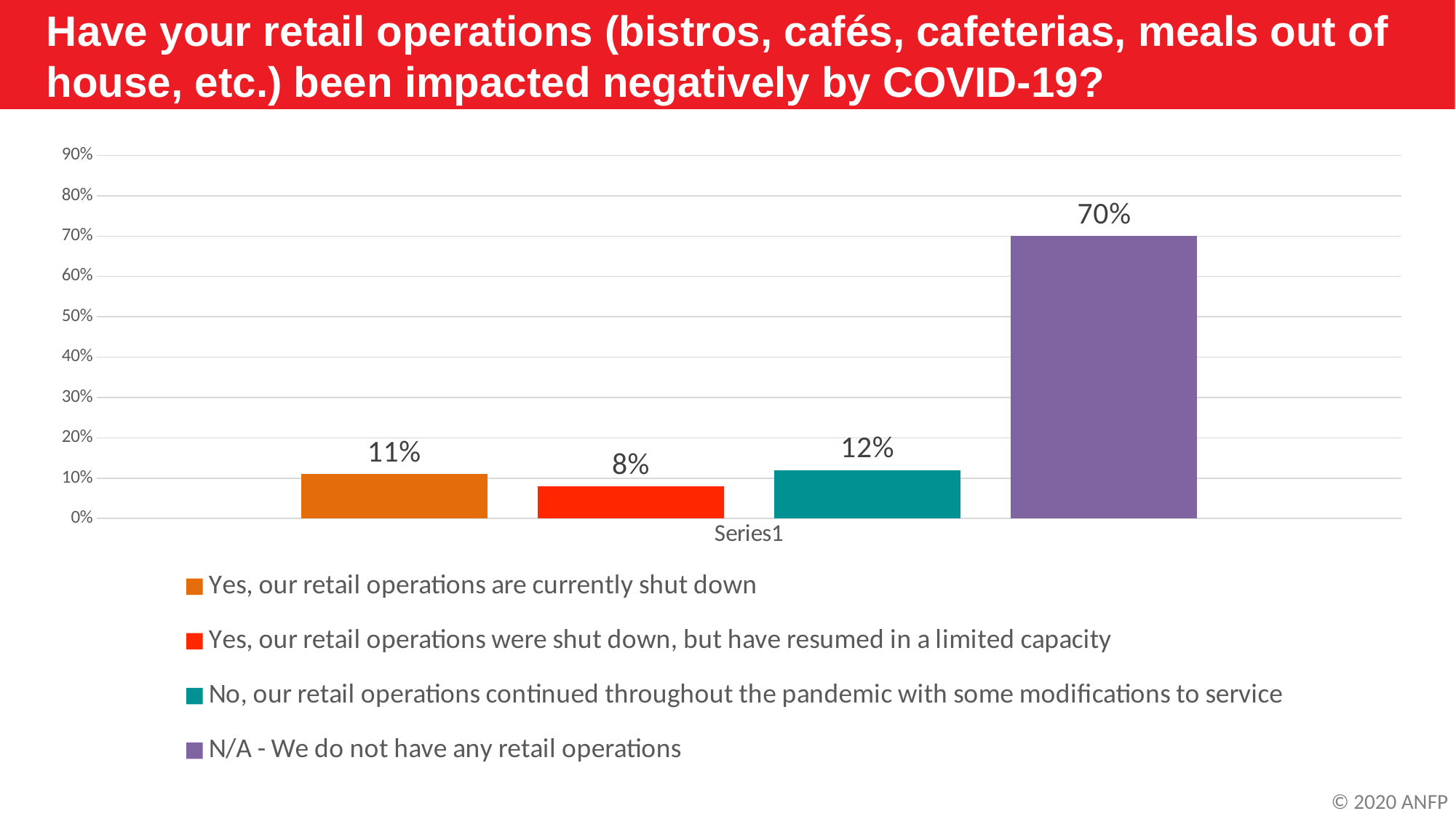
What colour is the bar for 'N/A - We do not have any retail operations'? Purple Which is larger: the share for 'continued throughout the pandemic with some modifications' or the share for 'currently shut down'? No, our retail operations continued throughout the pandemic with some modifications to service What is the difference in percentage points between the N/A response and the 'currently shut down' response? 59 Which response has the highest percentage? N/A - We do not have any retail operations Is the value for the N/A response greater or less than 60%? greater What type of chart is shown on the slide? Bar chart How many response categories are shown in the chart? 4 Which response has the lowest percentage? Yes, our retail operations were shut down, but have resumed in a limited capacity What percentage of respondents answered N/A - We do not have any retail operations? 70% What percentage of respondents said their retail operations are currently shut down? 11% What percentage of respondents said their retail operations were shut down but have resumed in a limited capacity? 8% What percentage of respondents said their retail operations continued throughout the pandemic with some modifications to service? 12%